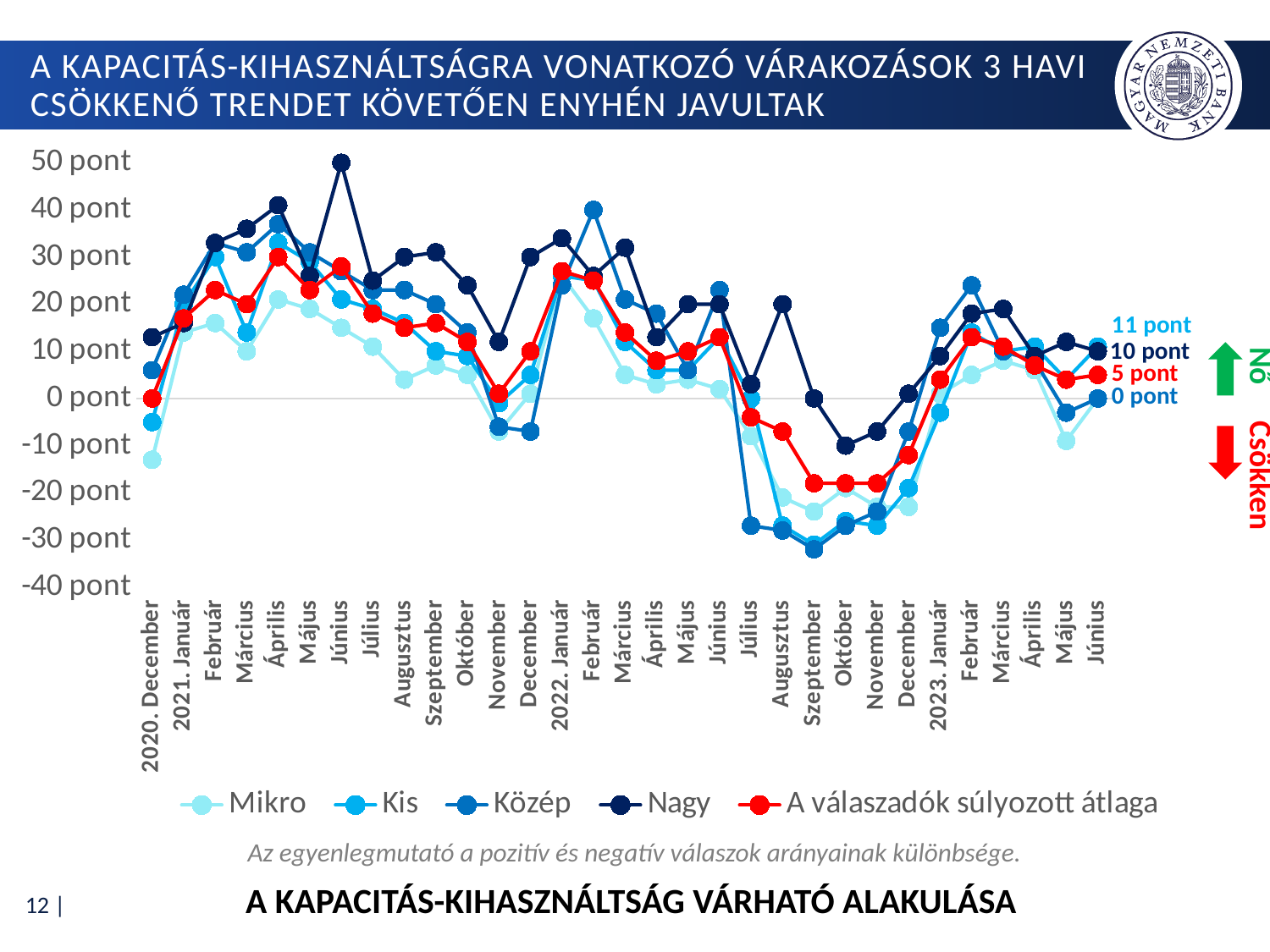
What is the value of the Nagy series at 2023 Június? 10 pont Is the value for Nagy at 2021 Június greater or less than 40 pont? greater What is the value of the Közép series at 2023 Június? 0 pont What is the value of the Kis series at 2023 Június? 11 pont How many months (data points) are shown along the x axis? 31 What kind of chart is shown on the slide? line chart How many series does the legend list? 5 Which series has the highest value at 2023 Június? Kis Does the weighted average ('A válaszadók súlyozott átlaga') rise or fall from 2022 Június to 2022 Szeptember? fall What is the value of 'A válaszadók súlyozott átlaga' at 2023 Június? 5 pont What is the difference between the Kis value and the weighted average ('A válaszadók súlyozott átlaga') at 2023 Június? 6 pont Is the value for Közép at 2022 Szeptember greater or less than -20 pont? less